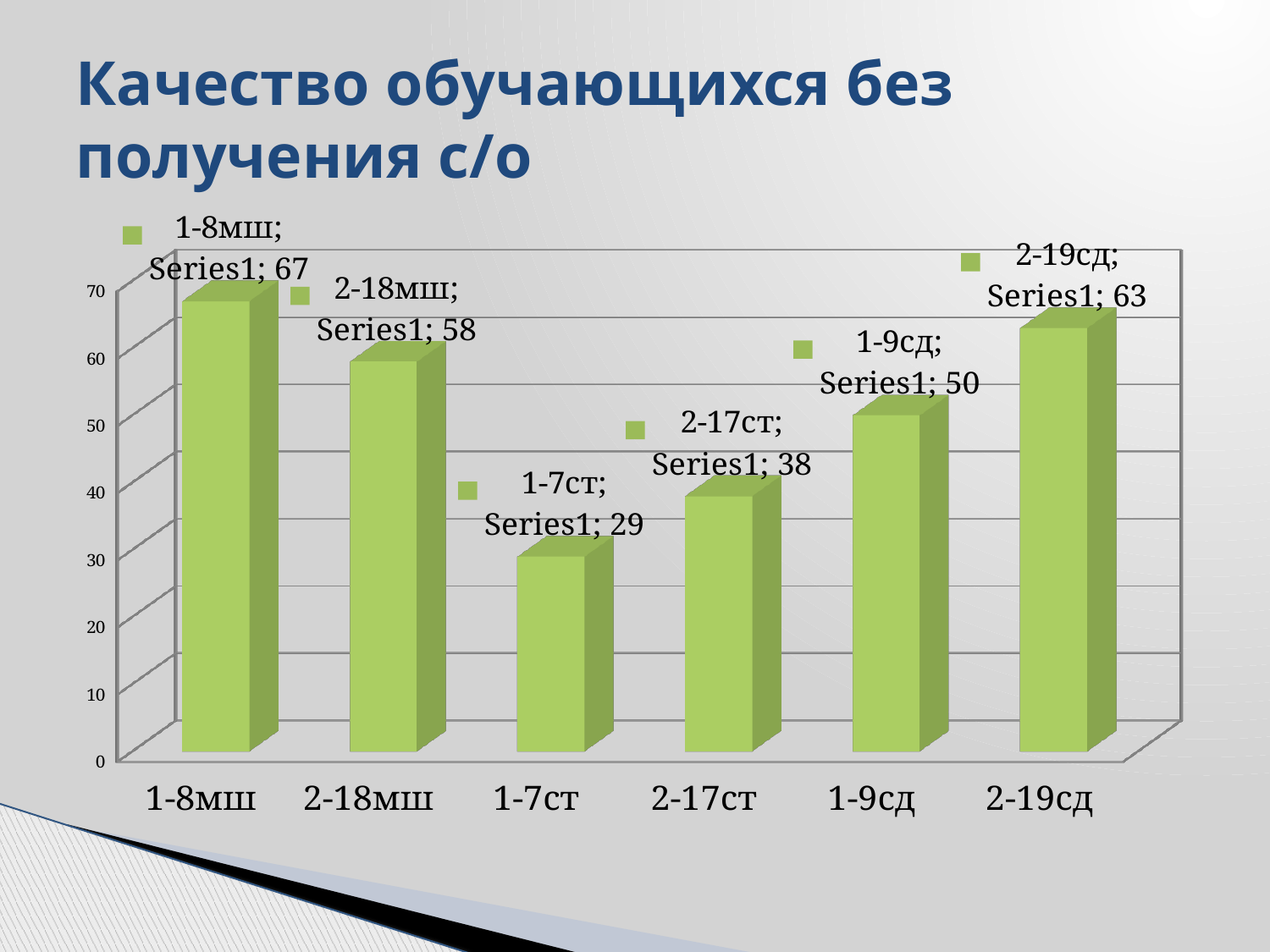
Which is larger, the value for 1-9сд or the value for 2-19сд? 2-19сд What is the title of the slide? Качество обучающихся без получения с/о How many categories are shown on the x axis? 6 What colour are the bars in the chart? green Which category has the highest value? 1-8мш What is the difference between the values for 2-18мш and 2-17ст? 20 What is the value for 1-7ст? 29 What is the value for 2-19сд? 63 What kind of chart is shown on the slide? bar chart Which category has the lowest value? 1-7ст What is the value for 1-8мш? 67 Is the value for 2-17ст greater or less than 40? less